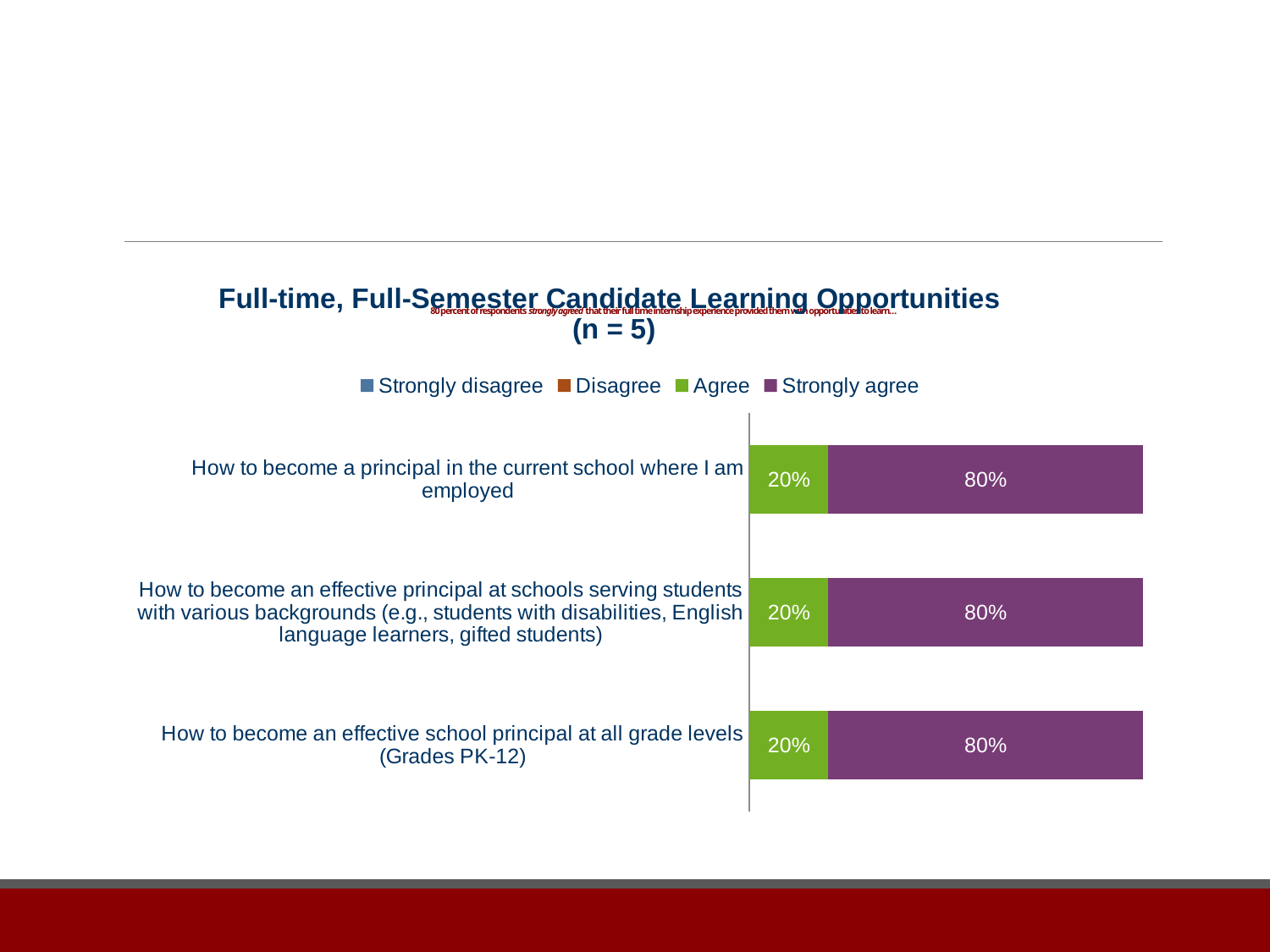
What is the sample size (n) given in the chart title? 5 What is the 'Agree' value for 'How to become a principal in the current school where I am employed'? 20% How many series does the legend list? 4 How many categories are shown on the chart? 3 For 'How to become an effective principal at schools serving students with various backgrounds', which is larger: 'Agree' or 'Strongly agree'? Strongly agree Which legend entry is shown in purple? Strongly agree For 'How to become an effective school principal at all grade levels (Grades PK-12)', what is the difference between the 'Strongly agree' and 'Agree' values? 60% What is the 'Strongly agree' value for 'How to become an effective principal at schools serving students with various backgrounds'? 80% What kind of chart is shown on the slide? Stacked bar chart What is the 'Agree' value for 'How to become an effective school principal at all grade levels (Grades PK-12)'? 20% What is the 'Strongly agree' value for 'How to become an effective school principal at all grade levels (Grades PK-12)'? 80% What is the total of the 'Agree' and 'Strongly agree' segments for 'How to become a principal in the current school where I am employed'? 100%